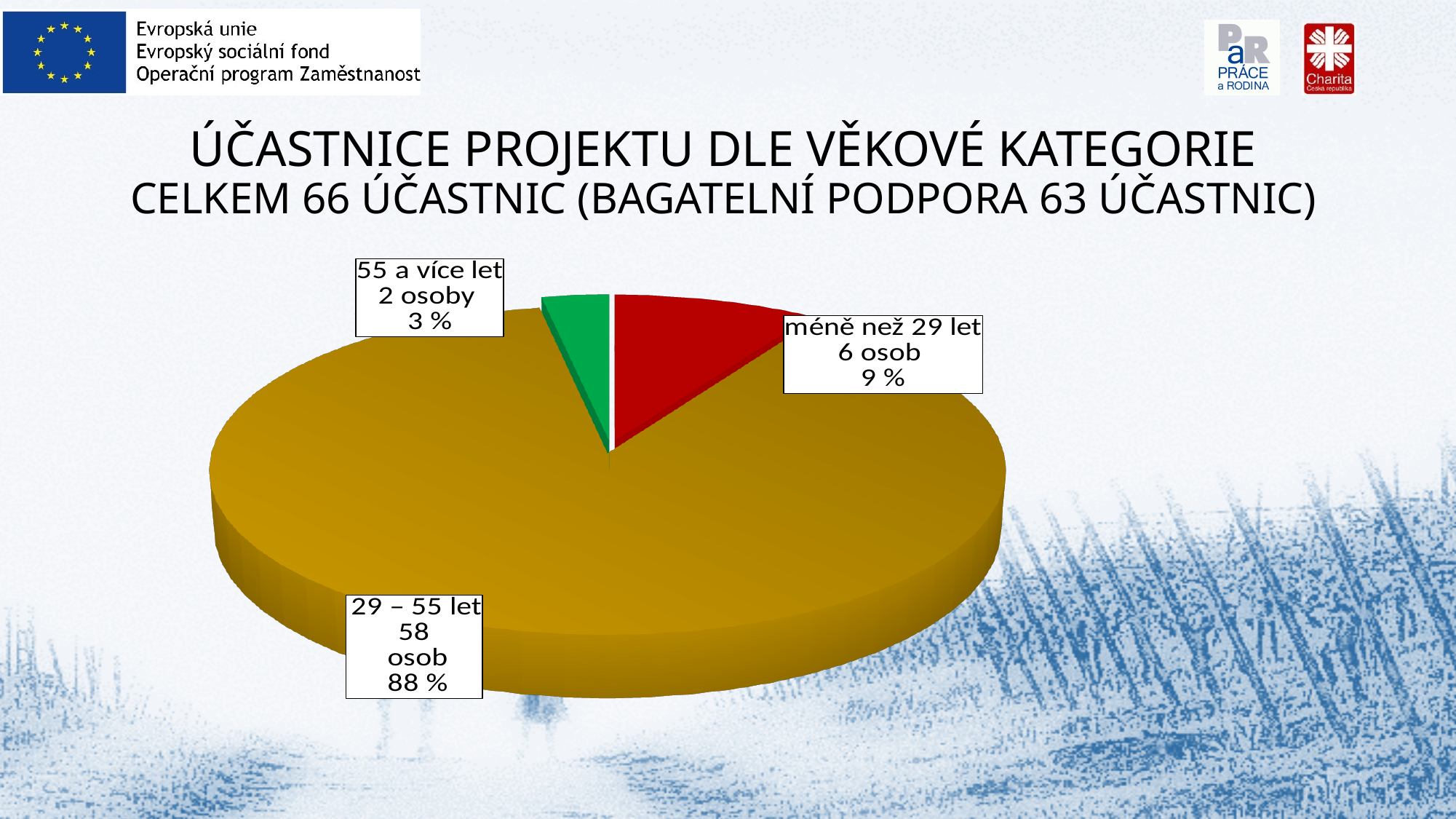
How many age categories does the pie chart show? 3 What kind of chart is shown on the slide? pie chart Which age category has the largest slice of the pie? 29 – 55 let How many people are in the '29 – 55 let' category? 58 osob What percentage share does the 'méně než 29 let' slice have? 9 % How many people are in the '55 a více let' category? 2 osoby Which age category has the smallest slice of the pie? 55 a více let What colour is the slice for the '55 a více let' category? green What is the title of the chart on the slide? ÚČASTNICE PROJEKTU DLE VĚKOVÉ KATEGORIE What percentage share does the '29 – 55 let' slice have? 88 % Which category has more people: 'méně než 29 let' or '55 a více let'? méně než 29 let What is the difference in number of people between the '29 – 55 let' and 'méně než 29 let' categories? 52